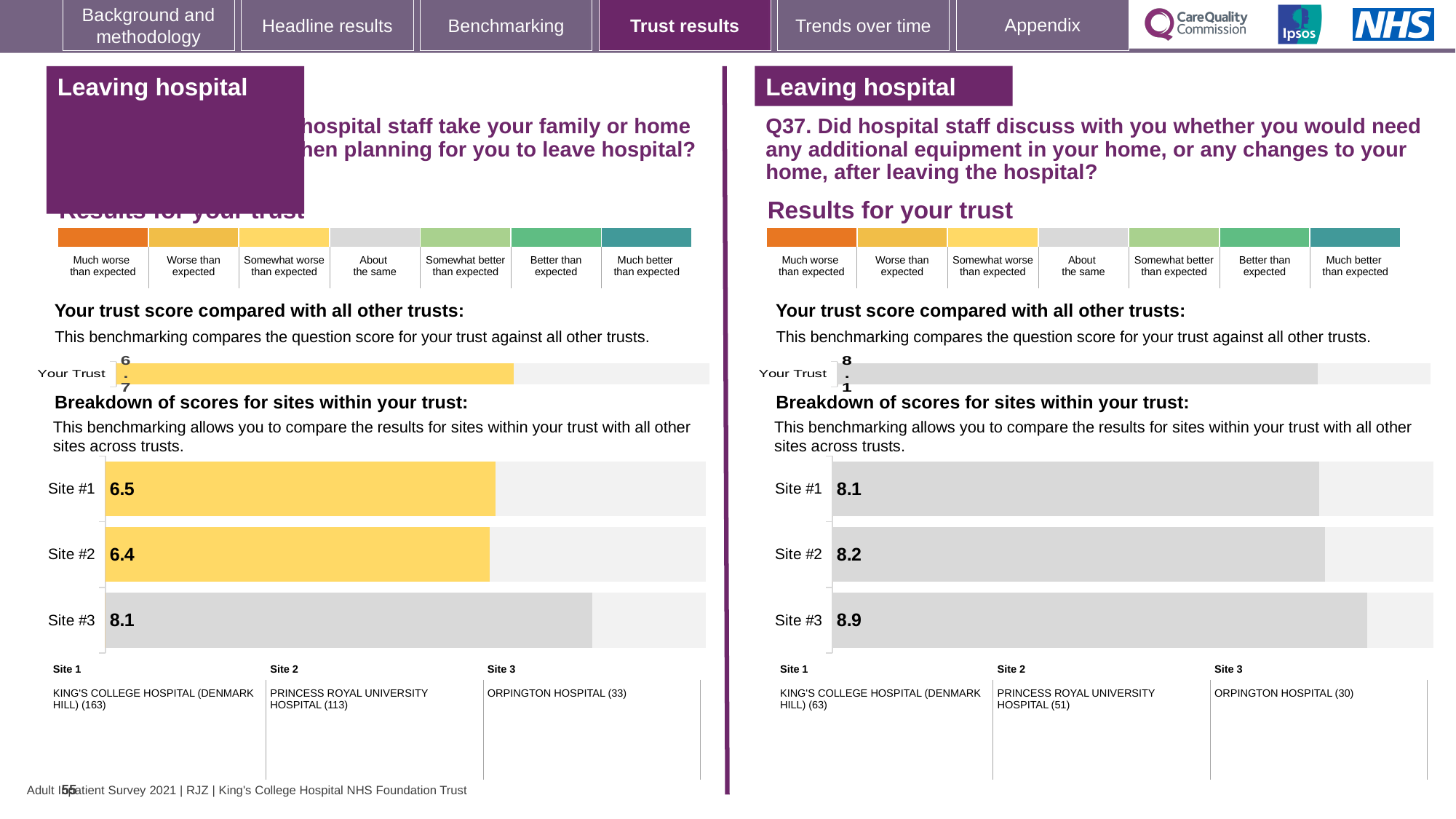
How many sites are shown on the left-hand site breakdown chart? 3 On the left-hand site breakdown chart, what is the score for Site #2? 6.4 On the right-hand (Q37) site breakdown chart, which site has the lowest score? Site #1 On the left-hand site breakdown chart, what is the difference between the scores for Site #3 and Site #1? 1.6 On the right-hand (Q37) site breakdown chart, do the scores rise or fall from Site #1 to Site #3? Rise On the right-hand (Q37) 'Your trust score compared with all other trusts' chart, what is the score for Your Trust? 8.1 On the right-hand (Q37) site breakdown chart, what is the difference between the scores for Site #3 and Site #2? 0.7 What type of chart is the right-hand (Q37) site breakdown chart? Bar chart On the left-hand 'Your trust score compared with all other trusts' chart, what is the score for Your Trust? 6.7 On the left-hand site breakdown chart, which site has the highest score? Site #3 On the right-hand (Q37) site breakdown chart, which has the larger score, Site #1 or Site #2? Site #2 On the right-hand (Q37) site breakdown chart, what is the score for Site #3? 8.9